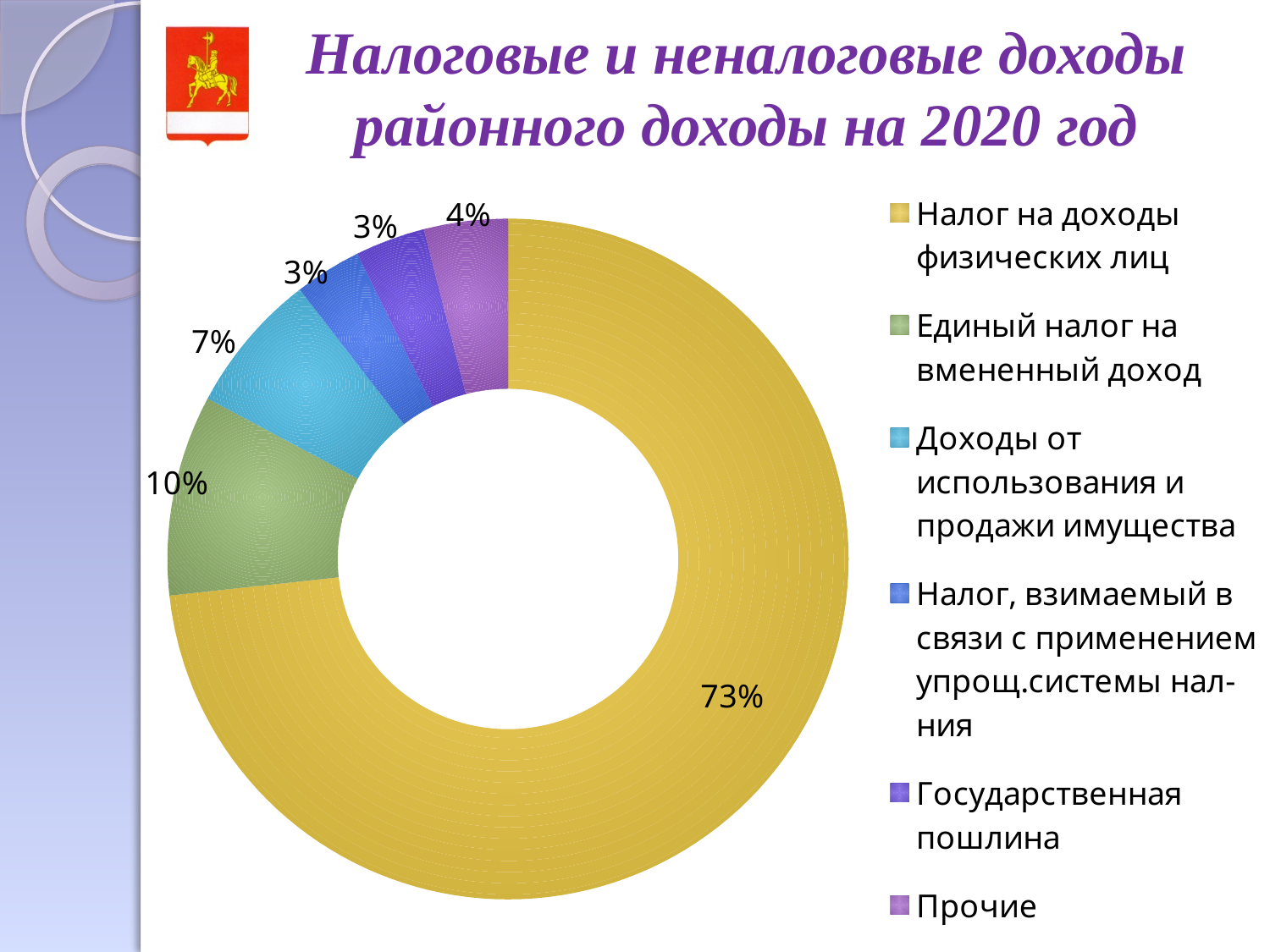
How many categories does the legend list? 6 What is the value shown for "Единый налог на вмененный доход"? 10% What kind of chart is shown on the slide? Doughnut (pie) chart What is the difference between the shares of "Налог на доходы физических лиц" and "Единый налог на вмененный доход"? 63% Which category has the largest share of the chart? Налог на доходы физических лиц What is the value shown for "Государственная пошлина"? 3% What is the combined share of "Единый налог на вмененный доход" and "Доходы от использования и продажи имущества"? 17% What is the value shown for "Прочие"? 4% What colour is the slice for "Налог на доходы физических лиц"? Yellow What share of the chart does "Налог на доходы физических лиц" account for? 73% What is the value shown for "Доходы от использования и продажи имущества"? 7% Which is larger: the share for "Доходы от использования и продажи имущества" or the share for "Прочие"? Доходы от использования и продажи имущества